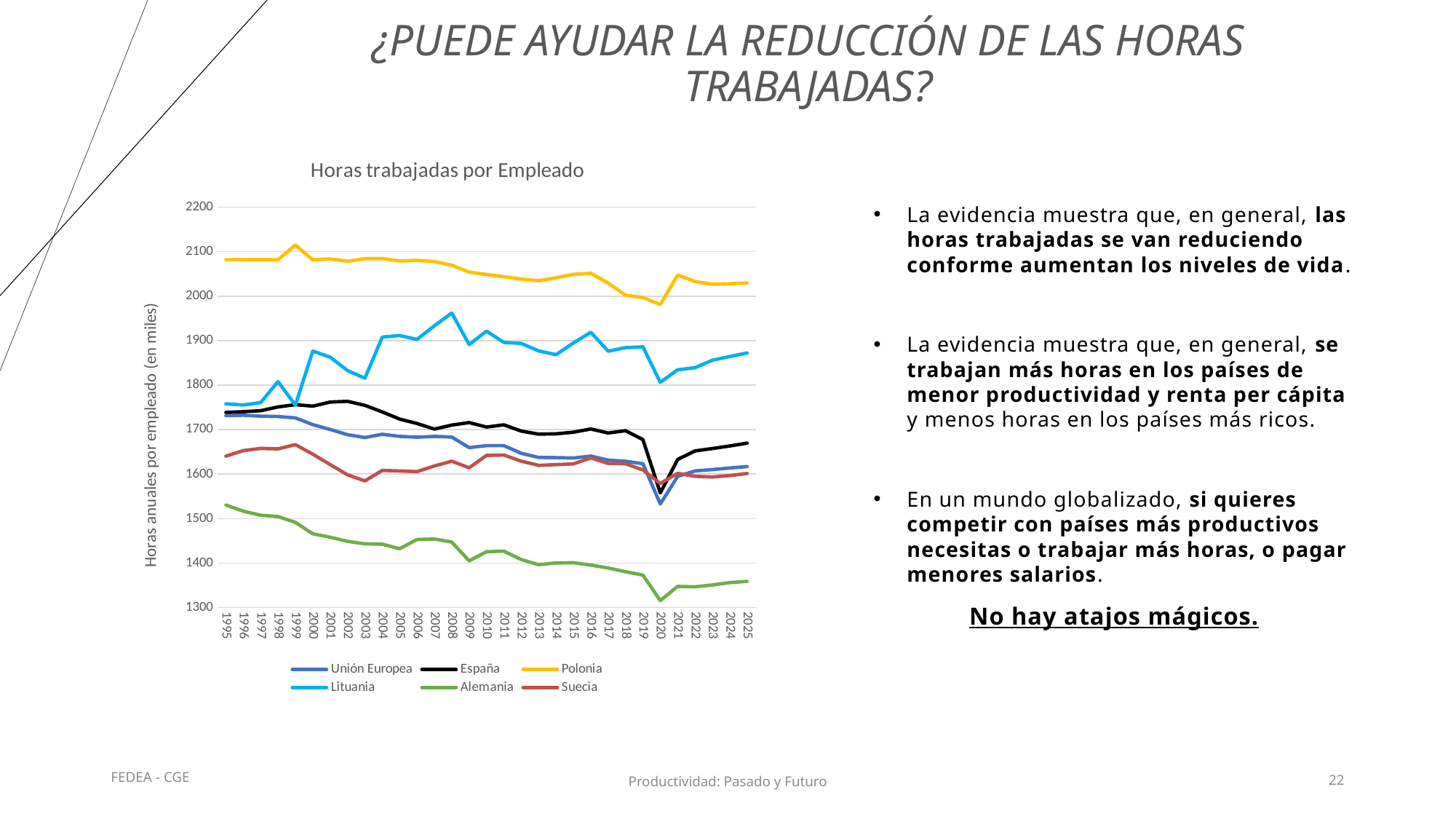
Which is larger in 1995, the value for Unión Europea or the value for Suecia? Unión Europea Is the value for Alemania in 2020 greater or less than 1400? less How many series does the legend of the chart list? 6 How many years are plotted along the x axis of the chart? 31 Which is larger in 2010, the value for Lituania or the value for España? Lituania What kind of chart is shown on the slide? line chart Do the values for Alemania generally rise or fall from 1995 to 2025? fall What is the title of the chart? Horas trabajadas por Empleado Which series has the highest values across the whole period in the chart? Polonia Is the value for Unión Europea in 2020 greater or less than 1600? less Which series has the lowest values across the whole period in the chart? Alemania Is the value for Polonia in 1995 greater or less than 2000? greater